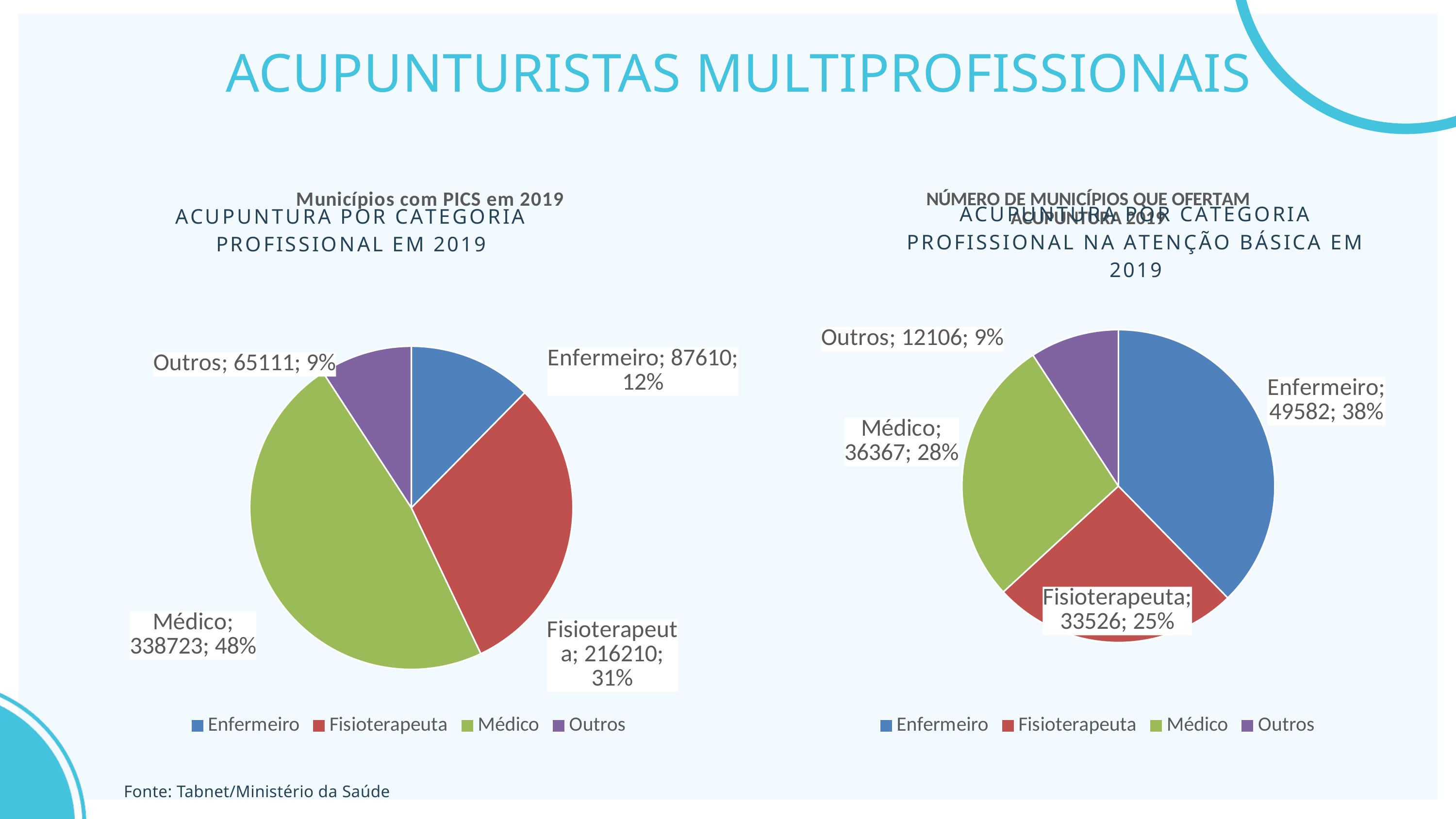
In the right pie chart, what is the difference between the values for Enfermeiro and Outros? 37476 In the right pie chart, which is larger, the value for Médico or the value for Fisioterapeuta? Médico In the right pie chart, what value is shown for Enfermeiro? 49582 In the left pie chart, what is the difference between the values for Médico and Fisioterapeuta? 122513 In the left pie chart, which category has the smallest value? Outros In the left pie chart, what value is shown for Médico? 338723 In the right pie chart, which category has the largest share? Enfermeiro How many categories does the legend of the right pie chart list? 4 In the left pie chart, what percentage share does Fisioterapeuta have? 31% What type of chart is the left chart on the slide? Pie chart In the left pie chart, which colour represents Médico? Green In the right pie chart, what percentage share does Médico have? 28%